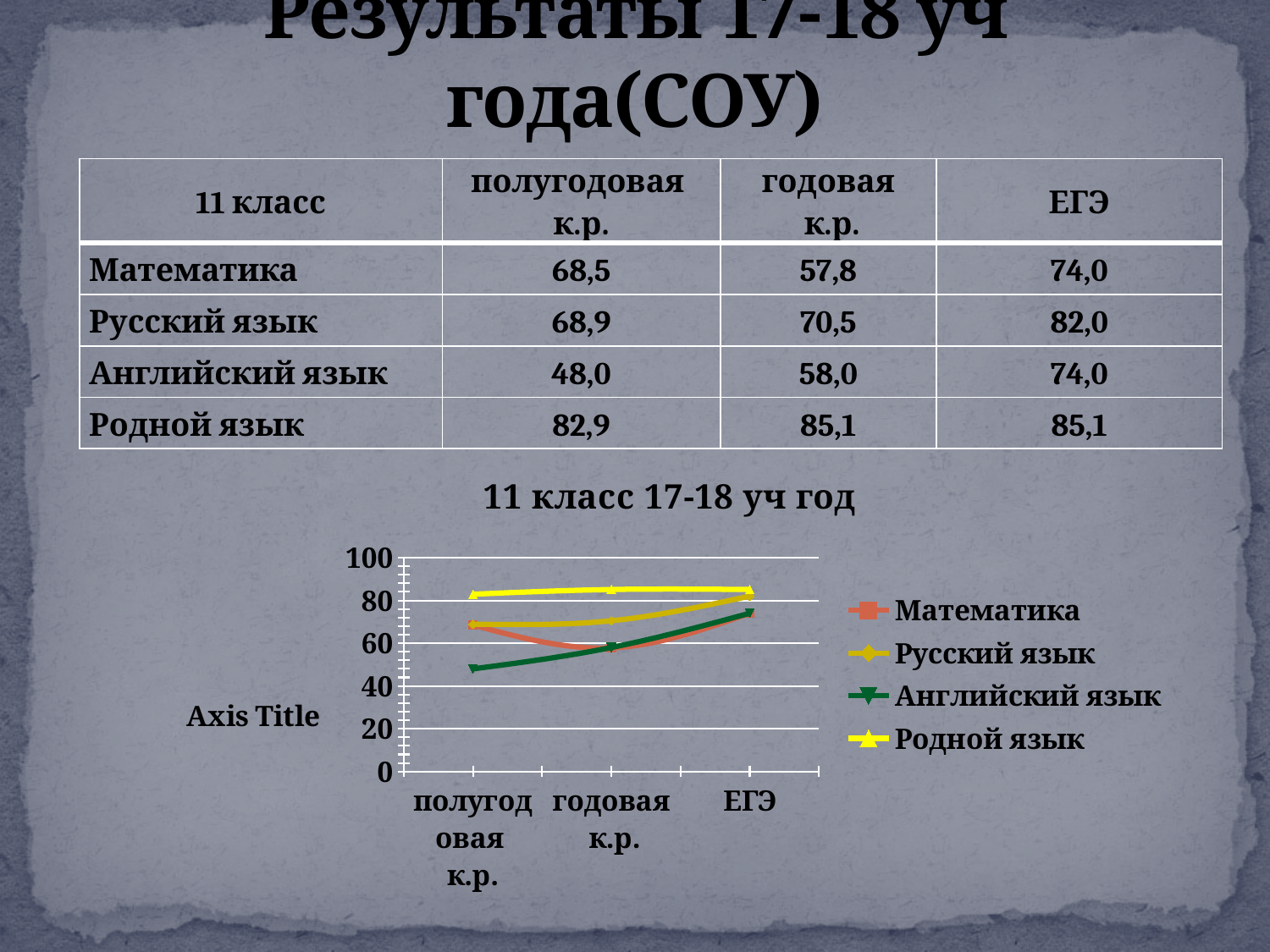
What is the value for Математика at ЕГЭ? 74,0 Does the value for Английский язык rise or fall from полугодовая к.р. to ЕГЭ? rise Which series has the highest value at полугодовая к.р.? Родной язык What is the difference between the ЕГЭ value and the полугодовая к.р. value for Русский язык? 13,1 What type of chart is shown on the slide? line chart What is the chart's title? 11 класс 17-18 уч год Which series has the lowest value at полугодовая к.р.? Английский язык How many series does the chart legend list? 4 At ЕГЭ, which is larger: Русский язык or Математика? Русский язык What is the value for Родной язык at полугодовая к.р.? 82,9 Is the value for Родной язык at годовая к.р. greater or less than 80? greater How many categories are shown along the x axis of the chart? 3